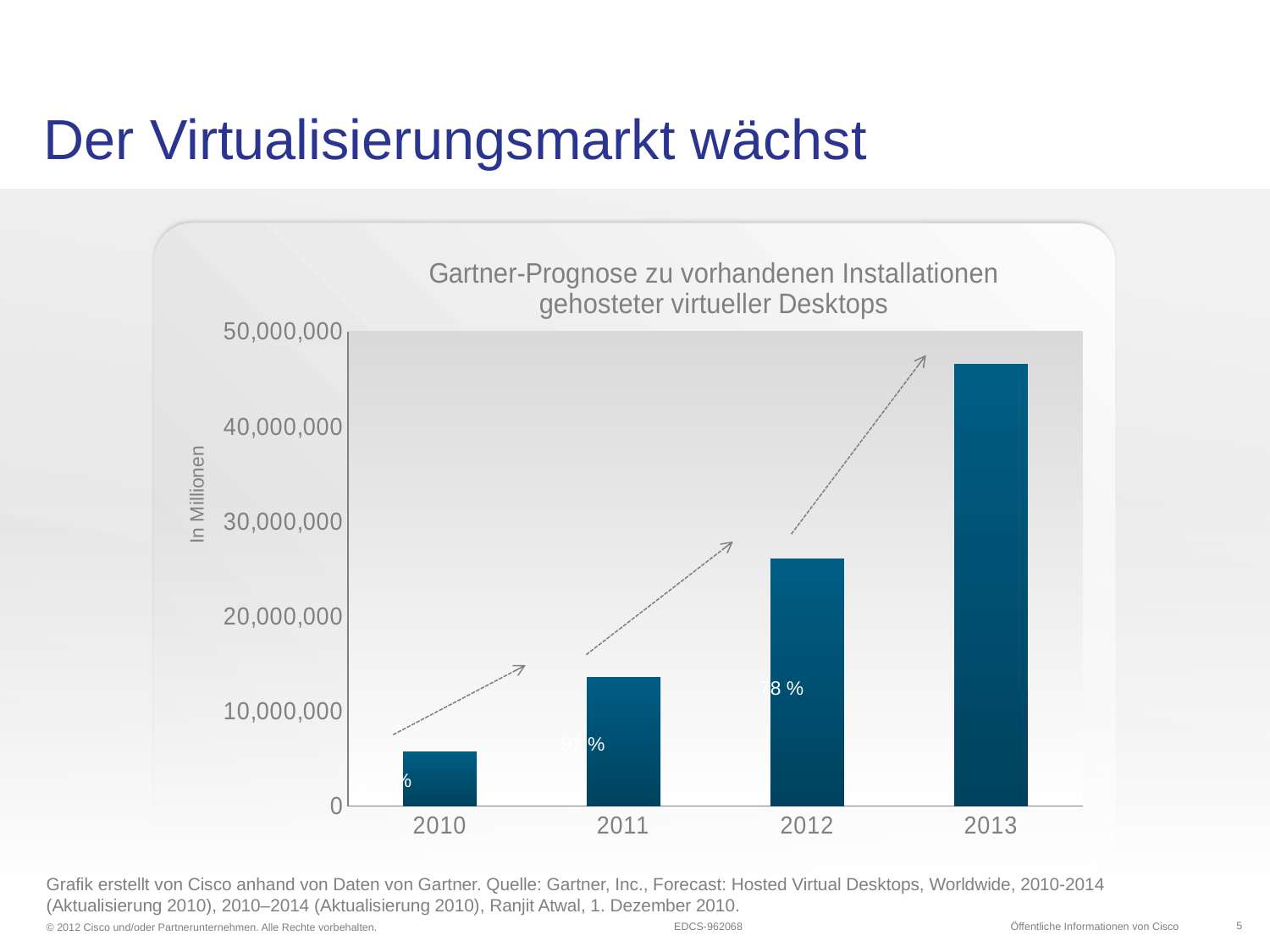
Is the value for 2012 greater or less than 20,000,000? greater Is the value for 2010 greater or less than 10,000,000? less What is the label on the y axis of the chart? In Millionen How many years are shown on the x axis of the chart? 4 Is the value for 2011 greater or less than 20,000,000? less Do the values rise or fall from 2010 to 2013? rise Which is larger, the value for 2011 or the value for 2012? 2012 What percentage label is printed on the bar for 2011? 91 % Which year has the lowest bar in the chart? 2010 Which year has the highest bar in the chart? 2013 What kind of chart is shown on the slide? bar chart